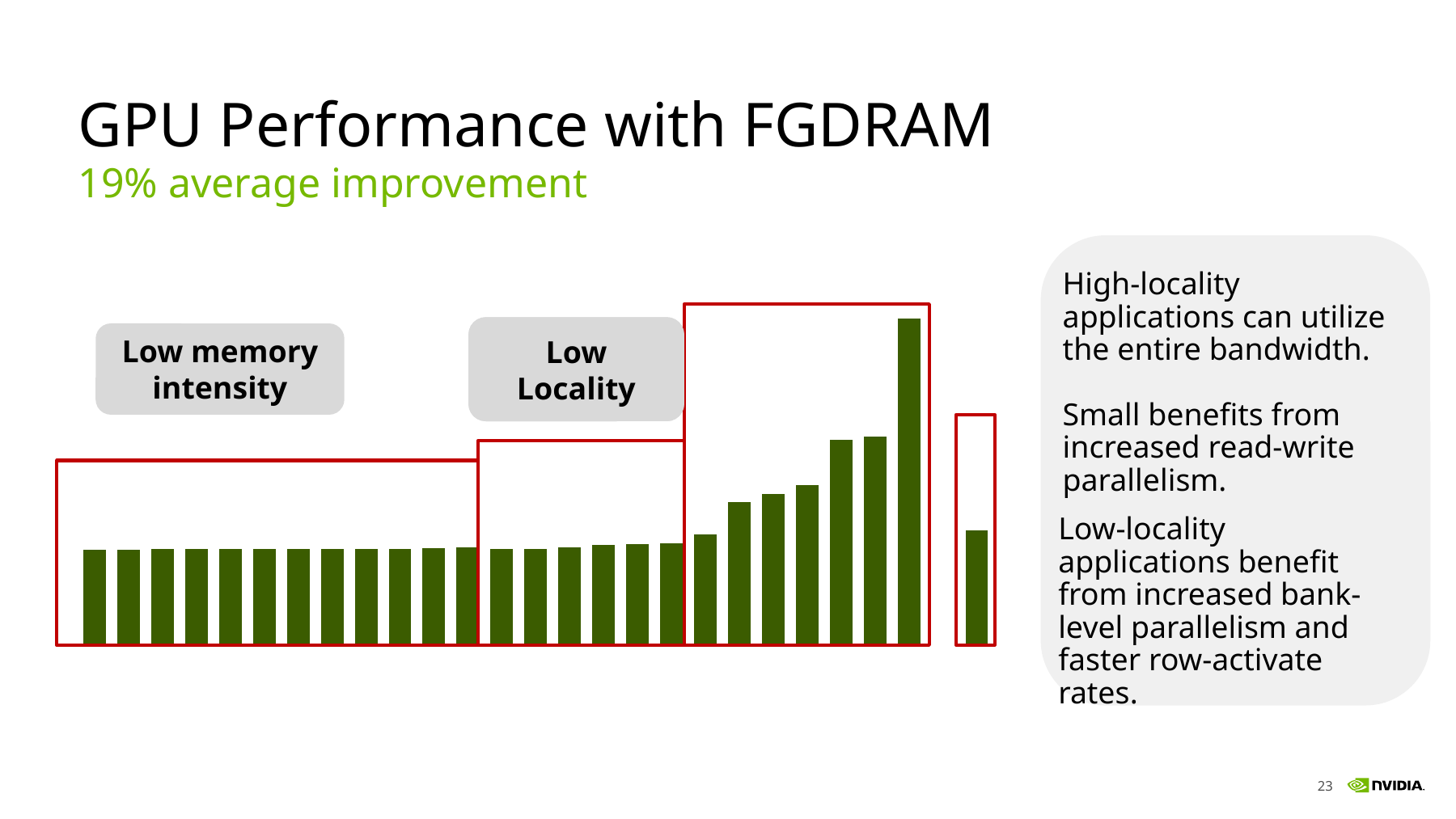
Is the rightmost bar in the third red box taller or shorter than the bars in the 'Low memory intensity' group? taller Which group of bars contains the tallest bar: the 'Low memory intensity' group, the 'Low Locality' group, or the unlabelled third group? the unlabelled third group How many bars are in the third (unlabelled) red box to the right of the 'Low Locality' group? 7 What is the title of the slide containing the chart? GPU Performance with FGDRAM What kind of chart is shown on the slide? bar chart How many bars are enclosed in the red box labelled 'Low Locality'? 6 What average improvement does the subtitle above the chart state? 19% average improvement Is the single bar in the far-right red box taller or shorter than the tallest bar in the third red box? shorter How many bars are enclosed in the red box labelled 'Low memory intensity'? 12 Do the bars in the third (unlabelled) red box rise or fall from left to right? rise